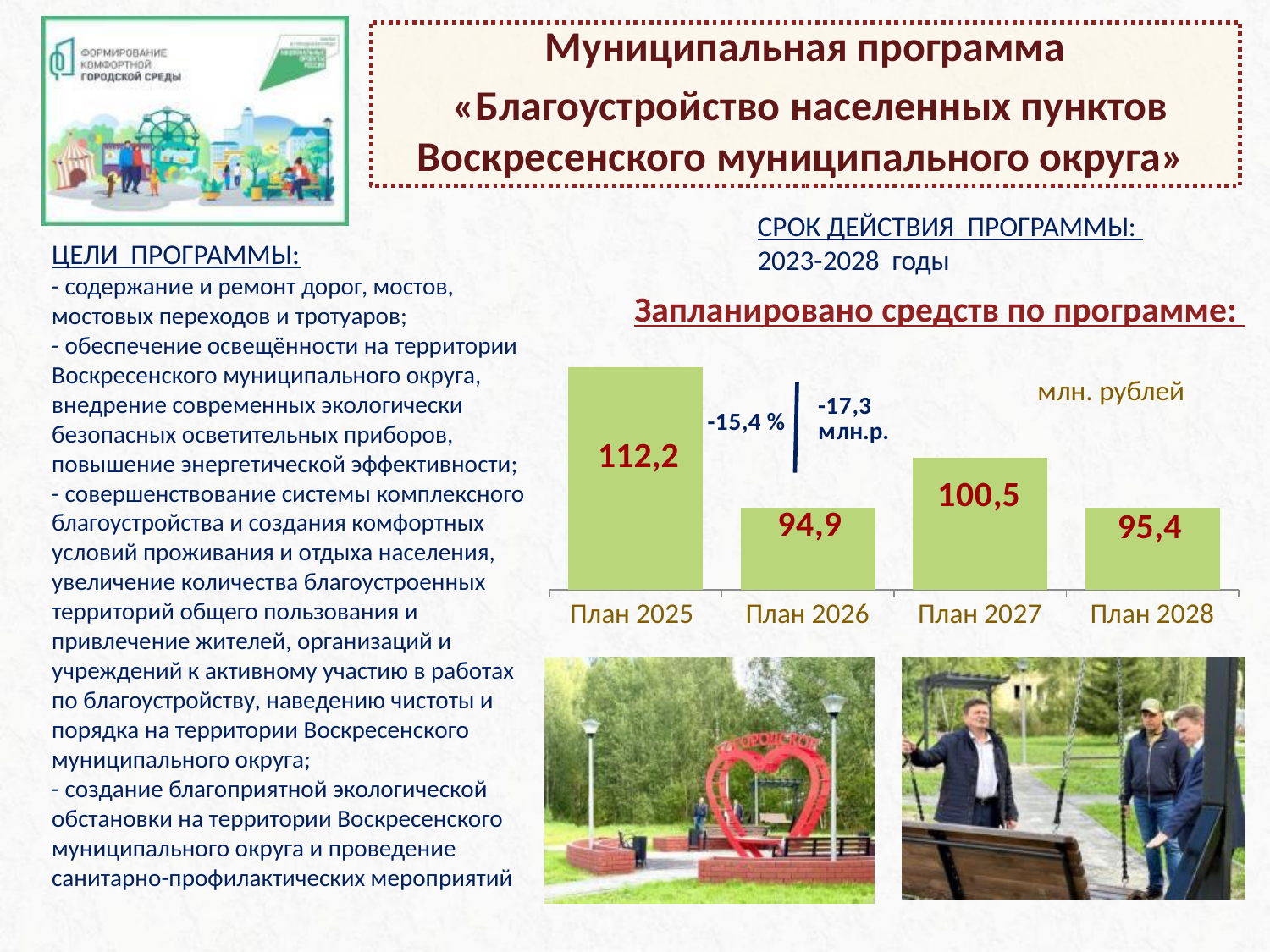
What is the difference between the planned amounts for План 2027 and План 2028? 5,1 How many years (categories) are shown on the chart? 4 What is the planned amount for План 2027 on the chart? 100,5 What is the planned amount for План 2026 on the chart? 94,9 What is the planned amount for План 2025 on the chart? 112,2 What is the planned amount for План 2028 on the chart? 95,4 What is the difference between the planned amounts for План 2025 and План 2026? 17,3 Which year has the highest planned amount on the chart? План 2025 Which year has the lowest planned amount on the chart? План 2026 What type of chart is used to show the planned funds? Bar chart Which is larger, the planned amount for План 2027 or for План 2028? План 2027 In what units are the values on the chart expressed? млн. рублей